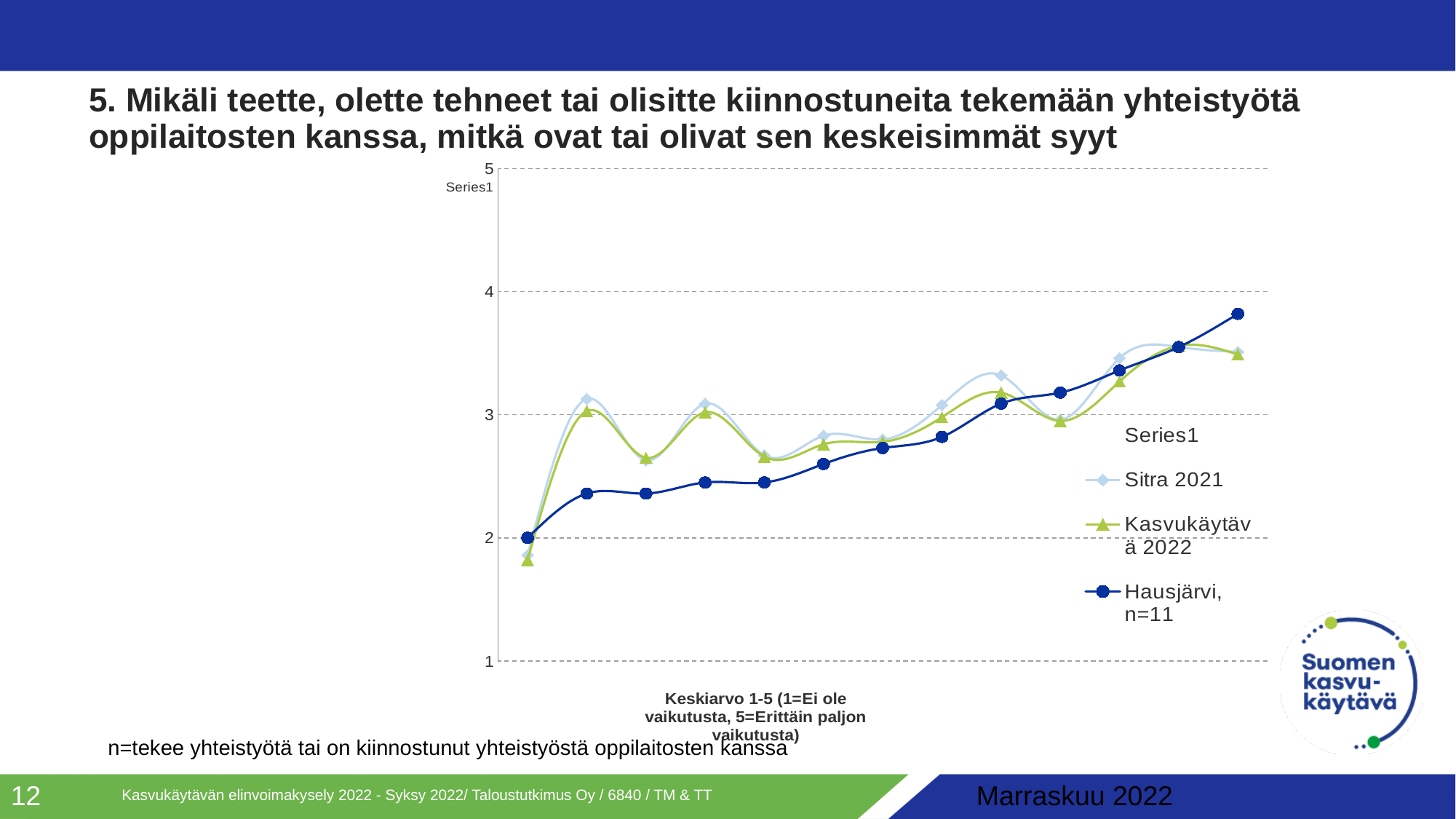
Is the value of the second Hausjärvi, n=11 point from the left greater or less than 2? greater Is the value of the rightmost Hausjärvi, n=11 point greater or less than 3? greater How many series does the chart legend list? 4 At the second point from the left, which series has the higher value: Kasvukäytävä 2022 or Hausjärvi, n=11? Kasvukäytävä 2022 How many data points does each line in the chart have? 13 Which series are listed in the chart legend? Series1, Sitra 2021, Kasvukäytävä 2022, Hausjärvi, n=11 Is the value of the leftmost Kasvukäytävä 2022 point greater or less than 2? less Which series reaches the highest value anywhere on the chart? Hausjärvi, n=11 Does the Hausjärvi, n=11 line generally rise or fall from left to right? rise What kind of chart is shown on the slide? line chart At the rightmost point, which series has the higher value: Hausjärvi, n=11 or Kasvukäytävä 2022? Hausjärvi, n=11 What is the highest value shown on the chart's vertical axis? 5